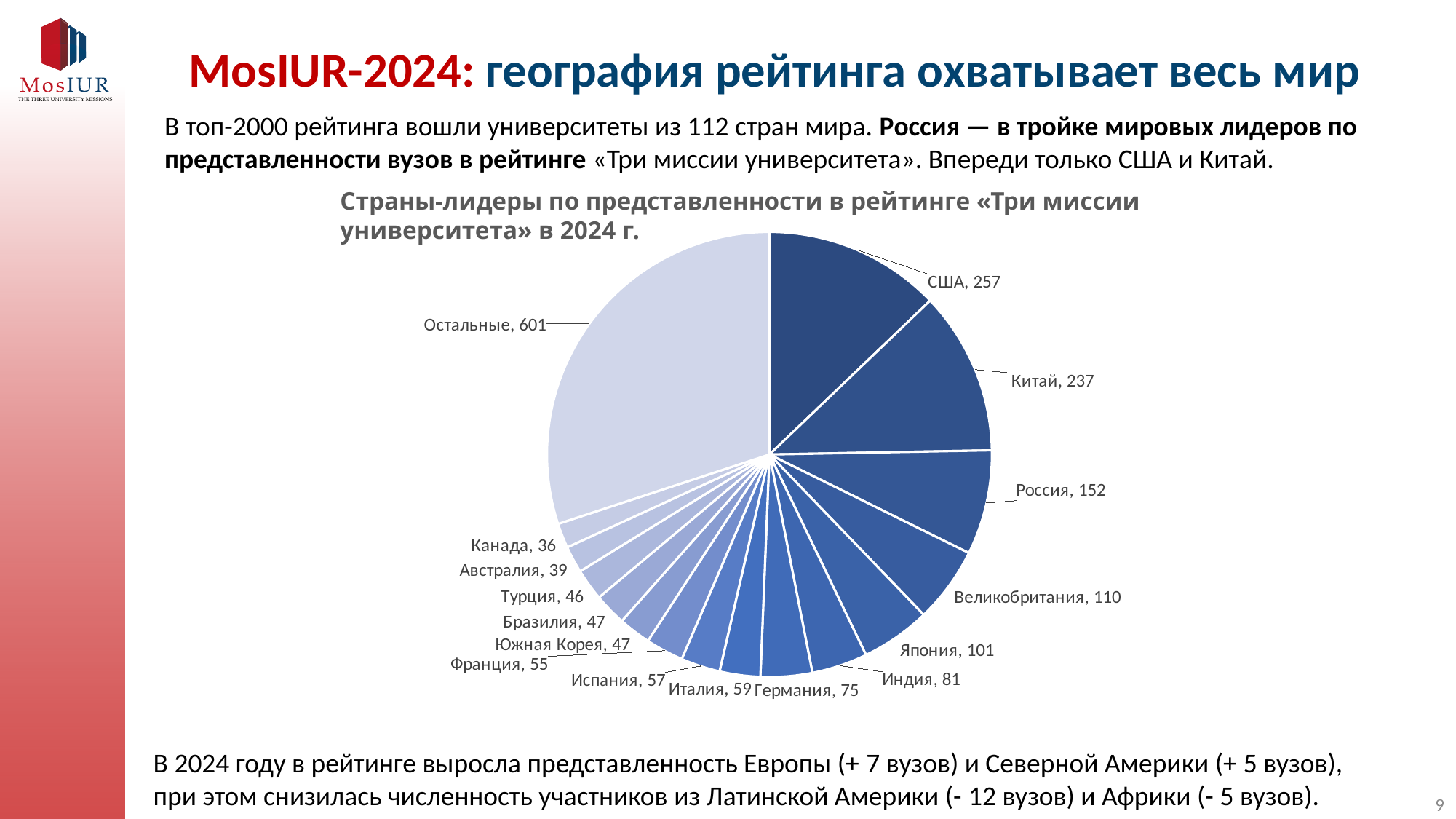
What is the value for Россия in the pie chart? 152 What share of the pie does Россия represent? 7.6% What is the value for Великобритания in the pie chart? 110 What is the title of the pie chart? Страны-лидеры по представленности в рейтинге «Три миссии университета» в 2024 г. What is the value for США in the pie chart? 257 How many slices does the pie chart have? 16 What is the difference between the values for Россия and Великобритания? 42 Which named country has the smallest slice in the pie chart? Канада Which slice of the pie chart is the largest? Остальные Which is larger, the value for Япония or the value for Индия? Япония What type of chart is shown on the slide? Pie chart What is the difference between the values for США and Китай? 20